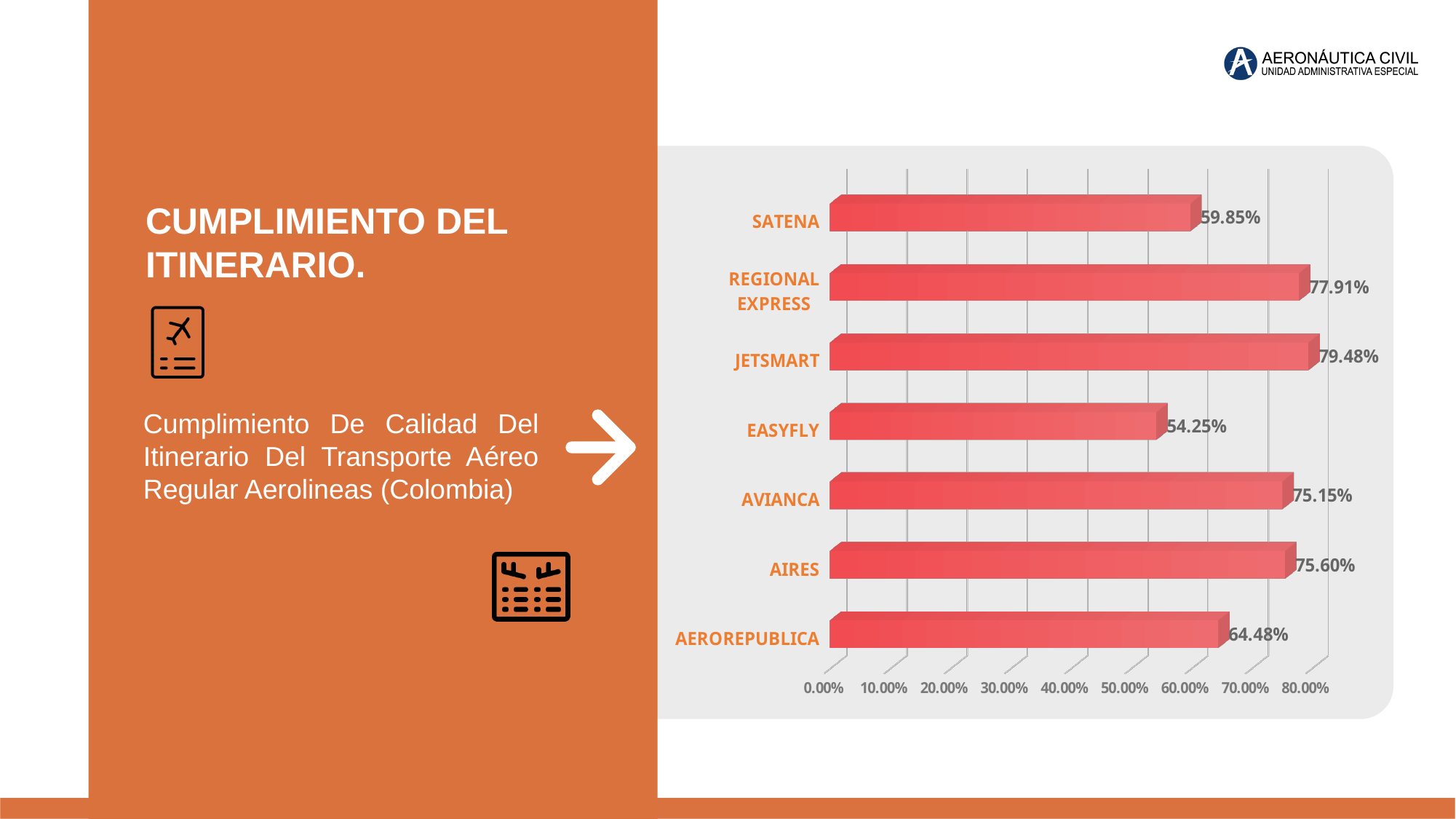
What is the value for AIRES? 75.60% Which airline has the lowest value? EASYFLY Which airline has the highest value? JETSMART What is the difference between the values for JETSMART and EASYFLY? 25.23% How many airlines are shown in the chart? 7 What is the difference between the values for SATENA and AEROREPUBLICA? 4.63% Which is larger, the value for AVIANCA or the value for SATENA? AVIANCA What kind of chart is shown on the slide? Bar chart What is the value for JETSMART? 79.48% What is the value for EASYFLY? 54.25% What is the value for AEROREPUBLICA? 64.48% What is the value for REGIONAL EXPRESS? 77.91%